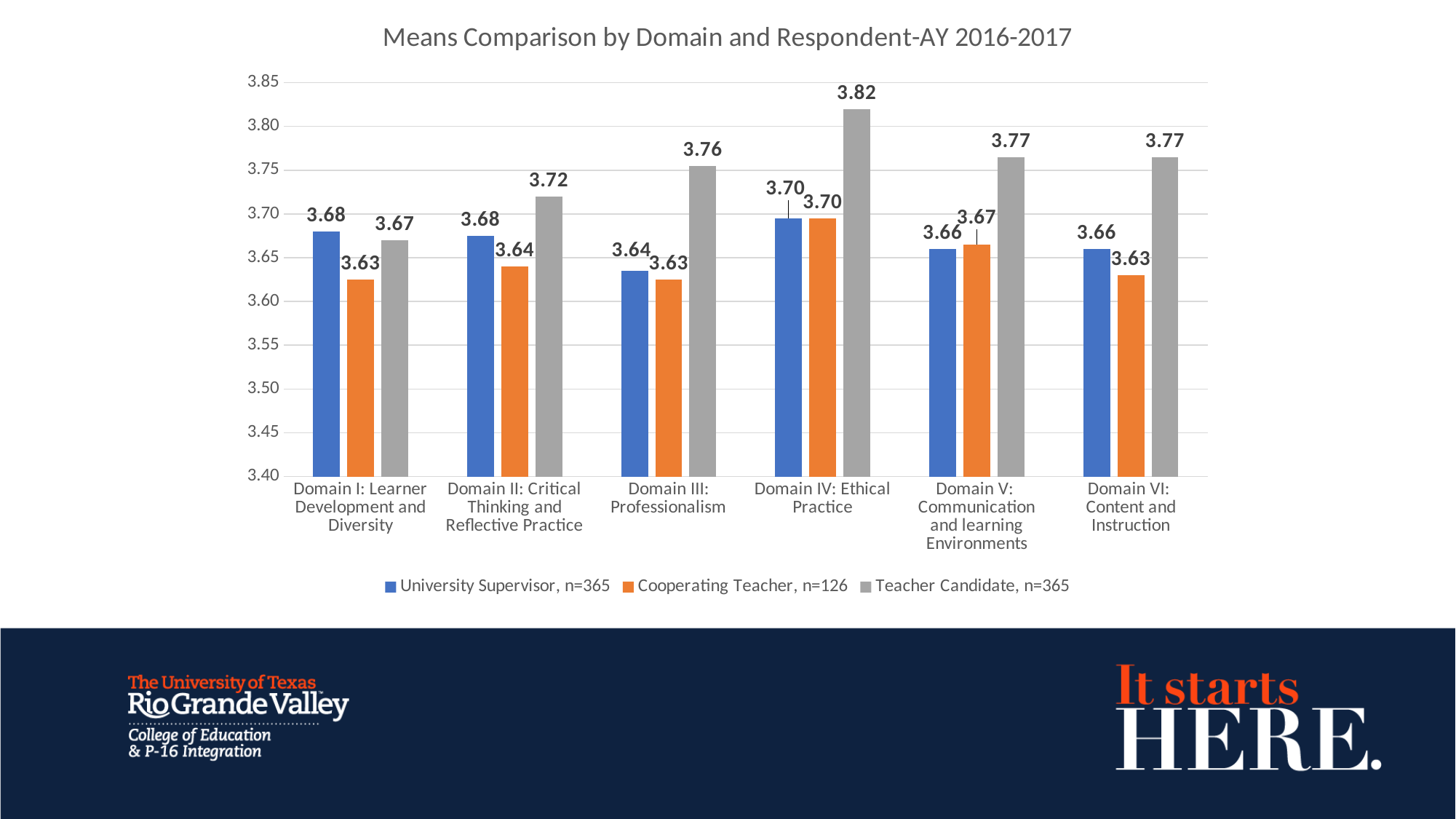
For Domain II: Critical Thinking and Reflective Practice, which is larger: the University Supervisor mean or the Teacher Candidate mean? Teacher Candidate Which domain has the highest Teacher Candidate mean? Domain IV: Ethical Practice How many domains are shown on the x axis? 6 How many series does the legend list? 3 Which domain has the lowest University Supervisor mean? Domain III: Professionalism What kind of chart is shown on the slide? Bar chart What is the University Supervisor mean for Domain I: Learner Development and Diversity? 3.68 What is the difference between the Teacher Candidate mean and the Cooperating Teacher mean for Domain III: Professionalism? 0.13 What is the title of the chart? Means Comparison by Domain and Respondent-AY 2016-2017 What is the Teacher Candidate mean for Domain IV: Ethical Practice? 3.82 Is the Teacher Candidate mean for Domain VI: Content and Instruction greater or less than 3.75? greater What is the Cooperating Teacher mean for Domain V: Communication and learning Environments? 3.67